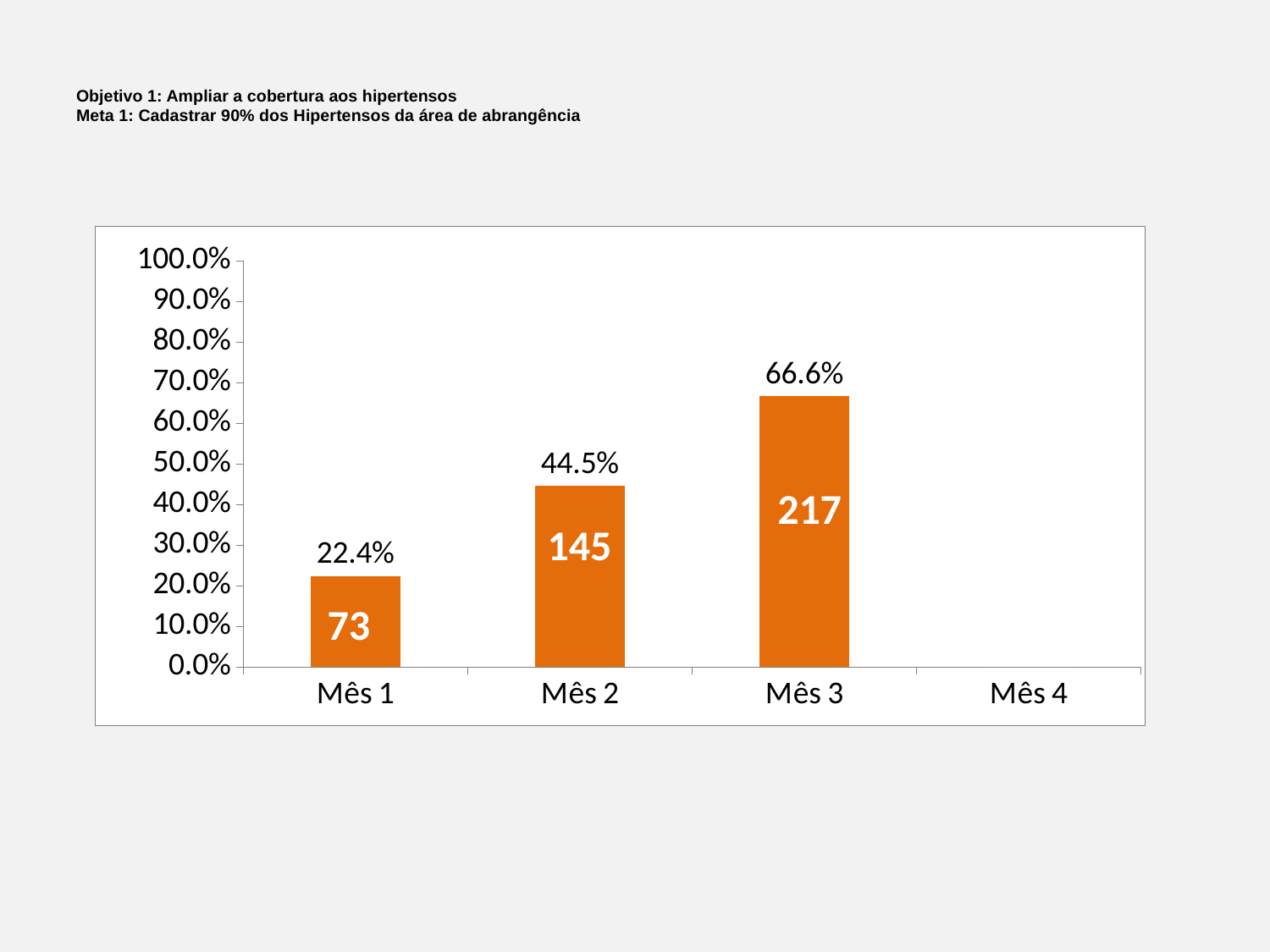
What count is printed inside the bar for Mês 1? 73 What kind of chart is shown? Bar chart What count is printed inside the bar for Mês 3? 217 Do the percentages rise or fall from Mês 1 to Mês 3? Rise What is the difference between the counts for Mês 2 and Mês 1? 72 Which month with a visible bar has the lowest percentage? Mês 1 What percentage is shown for Mês 3? 66.6% Which month has the highest percentage? Mês 3 Which is larger, the percentage for Mês 1 or for Mês 2? Mês 2 What percentage is shown for Mês 2? 44.5% How many month categories are shown on the x axis? 4 What is the difference in percentage points between Mês 3 and Mês 2? 22.1